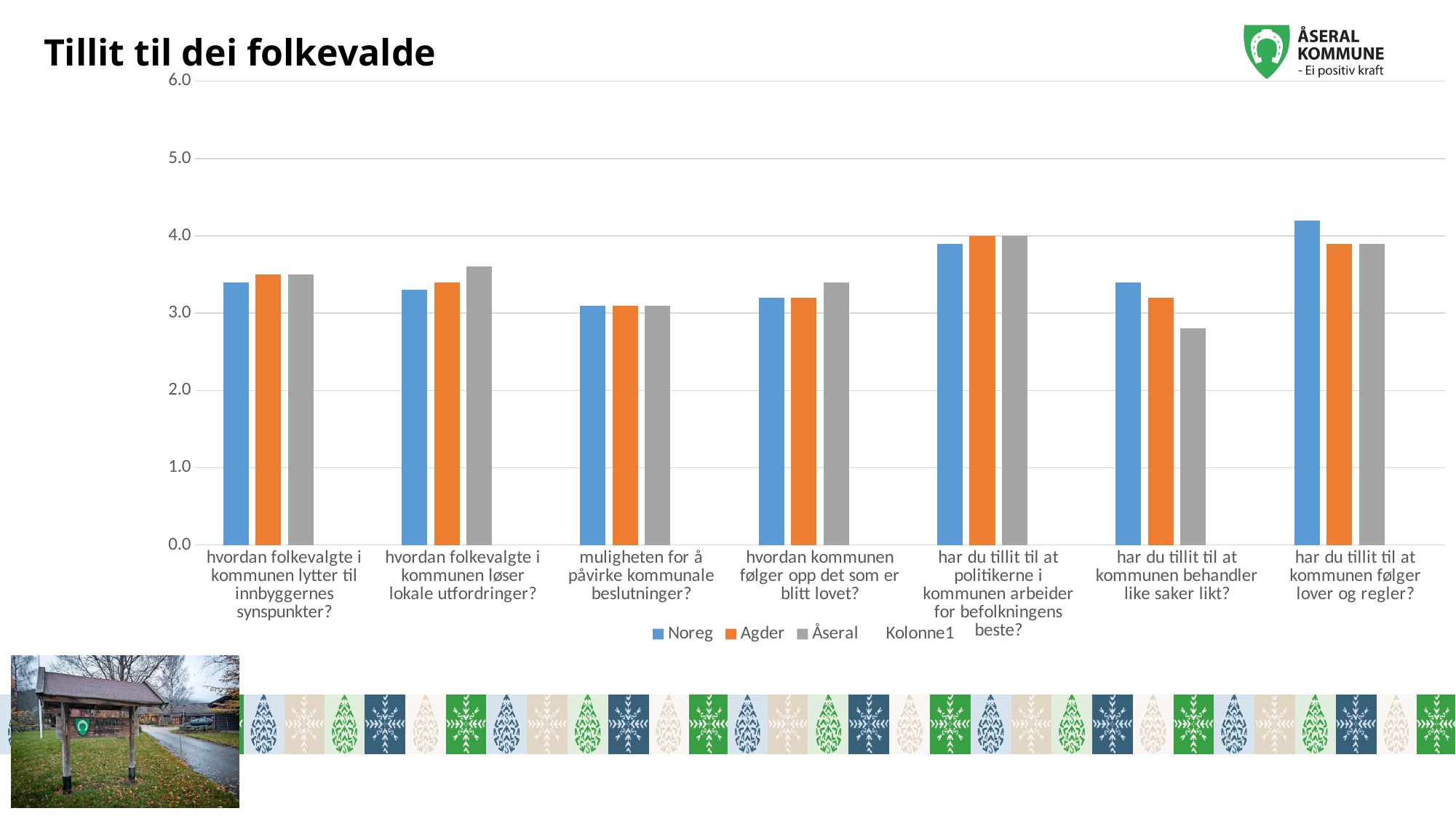
Is the Noreg value for 'har du tillit til at kommunen følger lover og regler?' greater or less than 4.0? greater What is the title of the slide? Tillit til dei folkevalde Is the Åseral value for 'har du tillit til at kommunen behandler like saker likt?' greater or less than 3.0? less For 'har du tillit til at kommunen behandler like saker likt?', which is larger: Noreg or Åseral? Noreg For 'hvordan folkevalgte i kommunen løser lokale utfordringer?', which is larger: Noreg or Åseral? Åseral For which category is the Noreg value highest? har du tillit til at kommunen følger lover og regler? Which colour represents the Noreg series? blue What kind of chart is shown on the slide? bar chart How many question categories are shown along the x axis? 7 Is the Åseral value for 'hvordan folkevalgte i kommunen løser lokale utfordringer?' greater or less than 3.0? greater For which category is the Åseral value lowest? har du tillit til at kommunen behandler like saker likt? How many entries does the legend list? 4